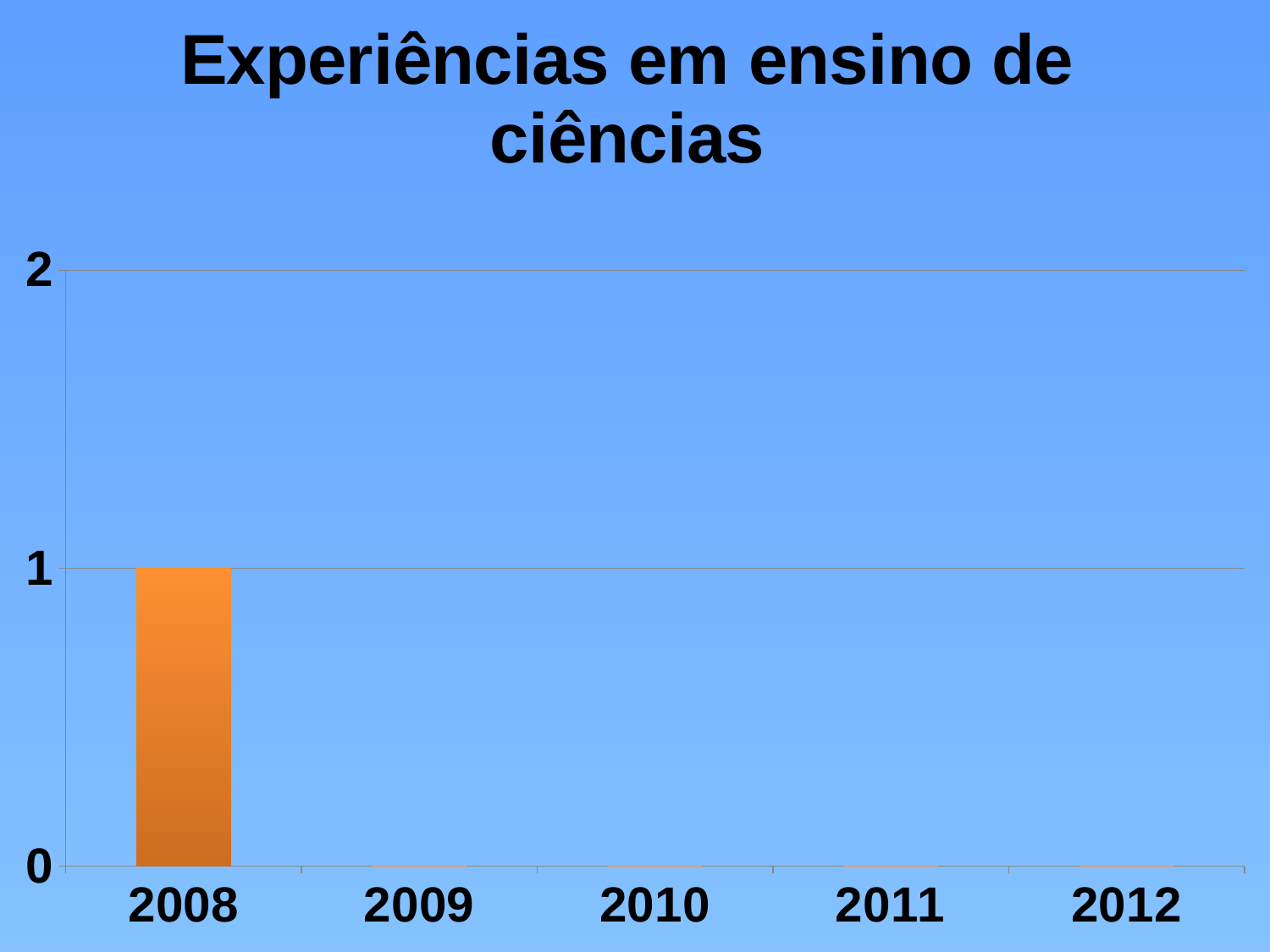
How many years are shown on the x axis of the chart? 5 What kind of chart is shown on the slide? bar chart What is the title of the chart? Experiências em ensino de ciências Which is larger, the value for 2008 or the value for 2009? 2008 How many years have a visible bar in the chart? 1 What is the highest value shown on the y axis? 2 Which is larger, the value for 2008 or the value for 2012? 2008 What is the value for 2008? 1 Which year has the highest value? 2008 Is the value for 2008 greater or less than 2? less